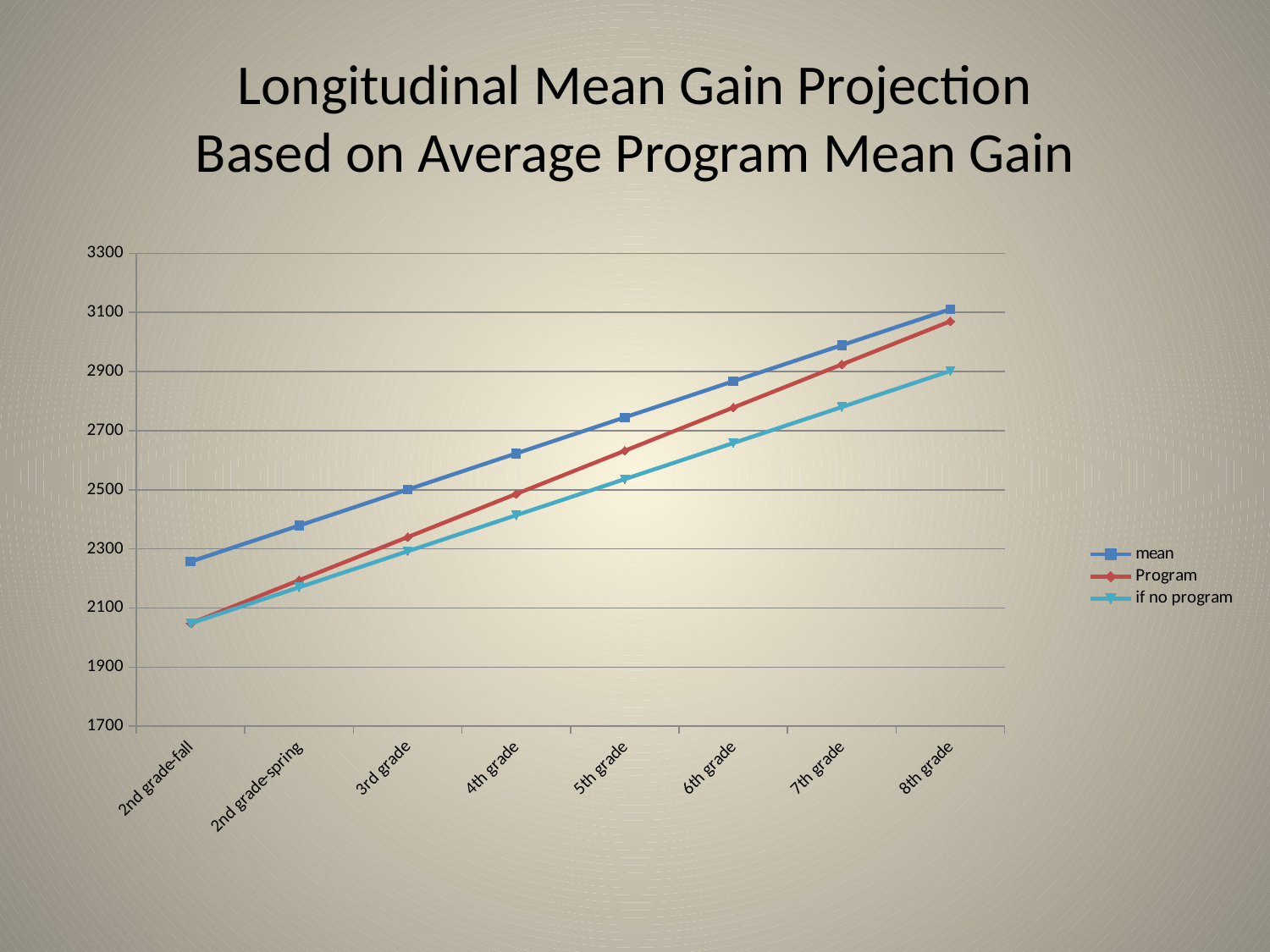
At 5th grade, which series has the highest value? mean How many grade categories are shown along the x axis? 8 Is the value for 'mean' at 2nd grade-fall greater or less than 2100? greater Is the value for 'mean' at 5th grade greater or less than 2700? greater At 6th grade, which is larger: the value for 'Program' or the value for 'if no program'? Program Is the value for 'Program' at 6th grade greater or less than 2700? greater Do the values for the 'mean' series rise or fall from 2nd grade-fall to 8th grade? rise What kind of chart is shown on the slide? line chart At 8th grade, which series has the lowest value? if no program How many series does the legend list? 3